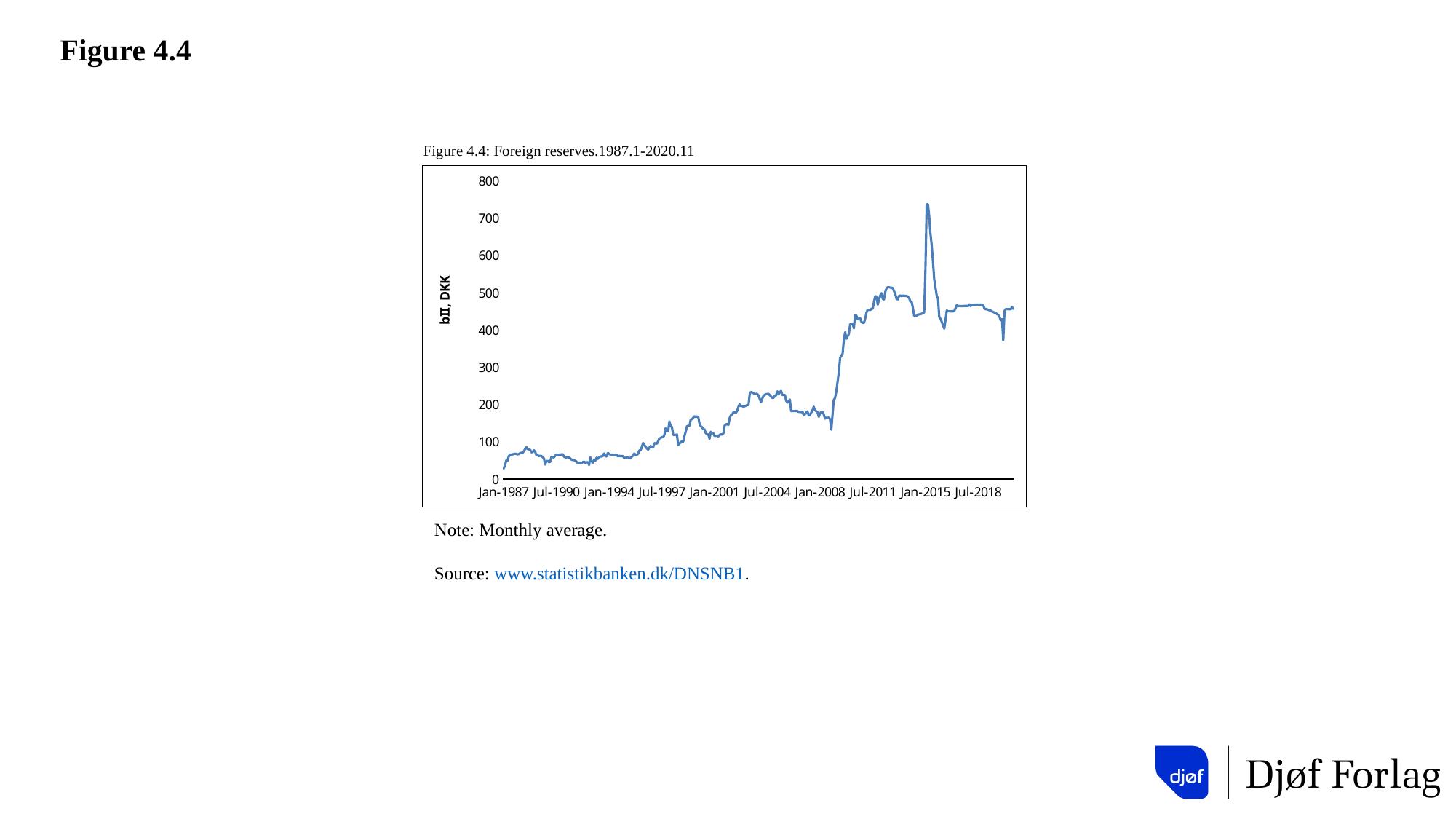
Is the highest peak of the line greater or less than 700? greater Is the value for Jul-1997 greater or less than 200? less Is the value for Jan-2008 greater or less than 300? less Which is larger, the value at Jan-1987 or the value at Jul-2018? Jul-2018 What is the label on the vertical axis of the chart? bll, DKK How many lines (series) are plotted in the chart? 1 Overall, do foreign reserves rise or fall from Jan-1987 to the end of the period? rise What kind of chart is shown on the slide? line chart What is the title of the chart? Figure 4.4: Foreign reserves.1987.1-2020.11